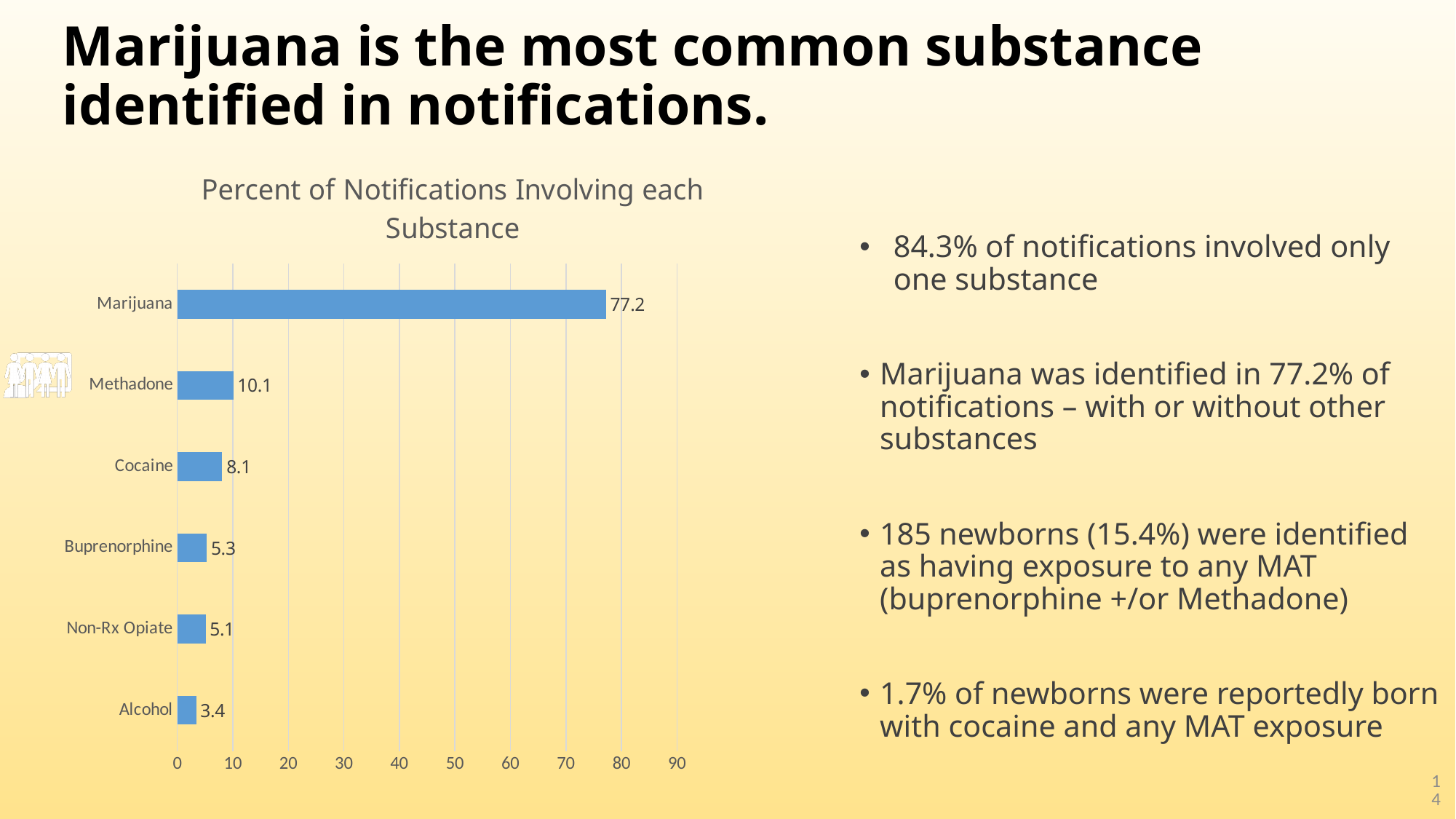
Which substance has the highest percent of notifications? Marijuana What is the value for Alcohol in the chart? 3.4 Which substance has the lowest percent of notifications? Alcohol What is the difference between the values for Cocaine and Alcohol? 4.7 Is the value for Marijuana greater or less than 70? greater What kind of chart is shown on the slide? Bar chart What is the title of the chart? Percent of Notifications Involving each Substance What is the difference between the values for Marijuana and Methadone? 67.1 What is the value for Methadone in the chart? 10.1 Which is larger, the value for Cocaine or the value for Buprenorphine? Cocaine How many substances are shown in the chart? 6 What is the value for Marijuana in the chart? 77.2